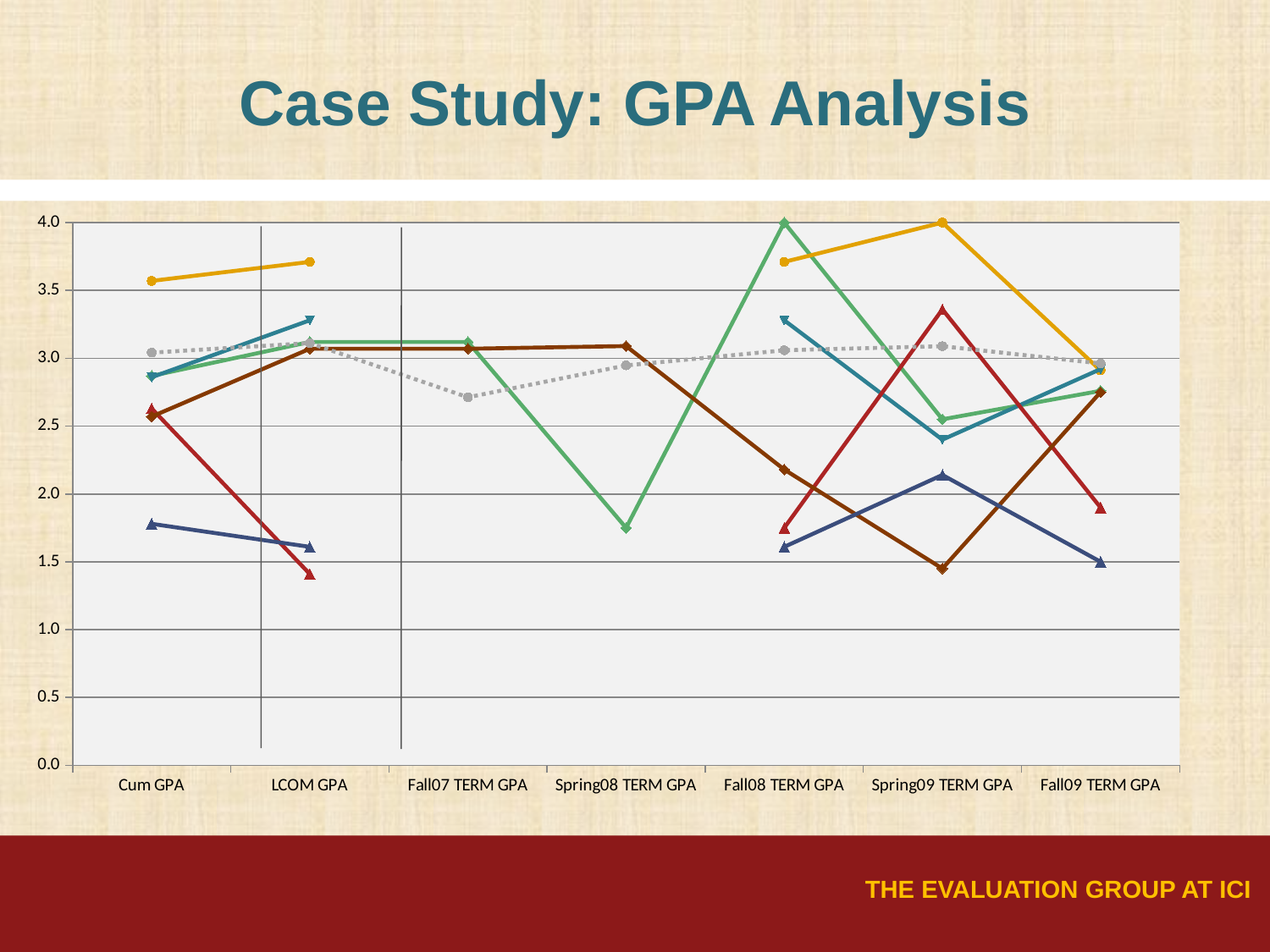
What kind of chart is shown on the slide? line chart Does the red line rise or fall from Cum GPA to LCOM GPA? fall Does the orange line rise or fall from Cum GPA to LCOM GPA? rise What is the highest value shown on the y axis of the chart? 4.0 Is the value of the orange line at Fall08 TERM GPA greater or less than 3.5? greater What is the first category on the x axis of the chart? Cum GPA Is the value of the brown line at Spring09 TERM GPA greater or less than 2.0? less Is the value of the green line at Spring08 TERM GPA greater or less than 2.0? less How many categories are shown along the x axis of the chart? 7